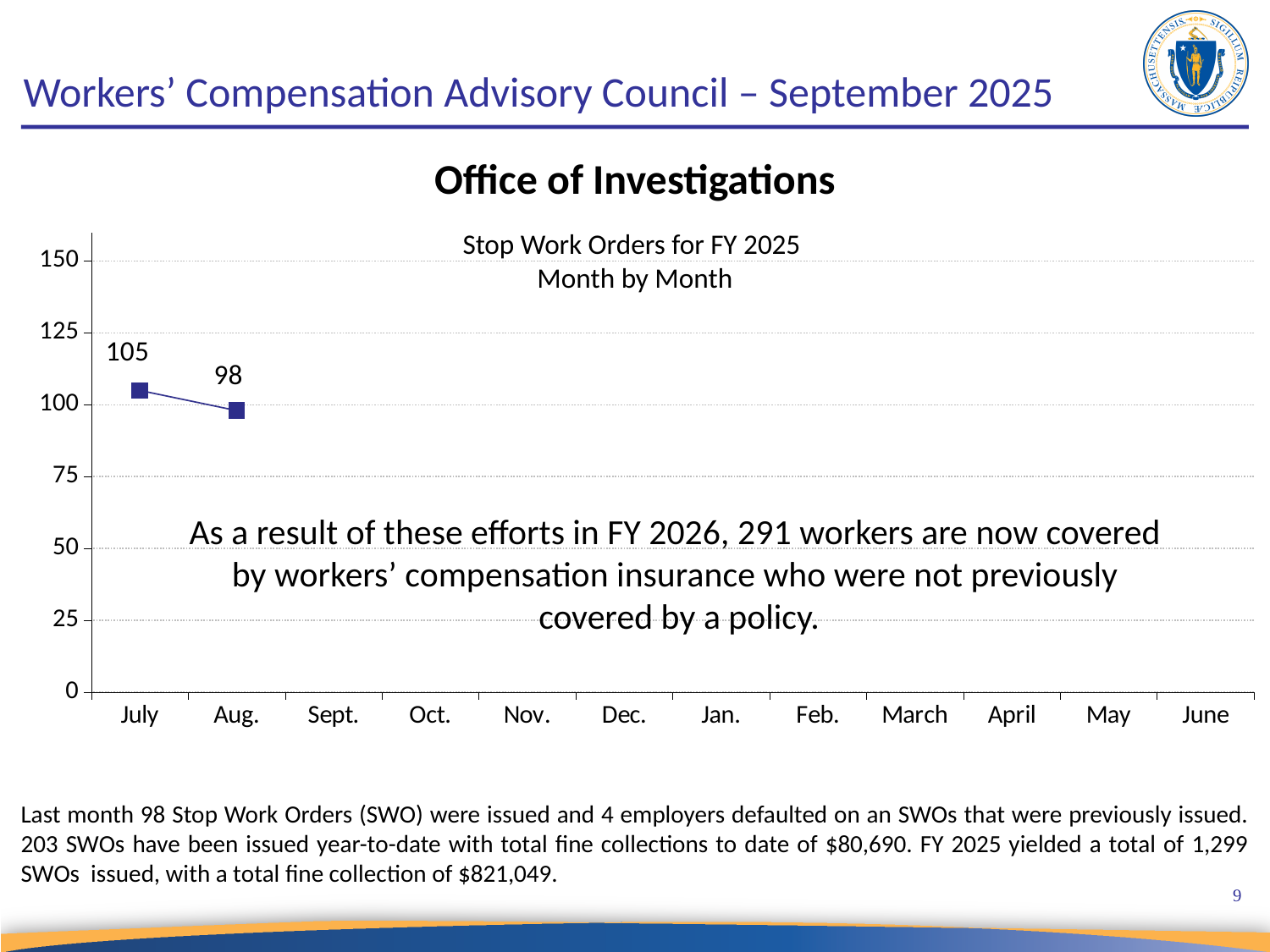
Is the value for Aug. in the Stop Work Orders chart greater or less than 100? less Do the plotted values rise or fall from July to Aug. in the Stop Work Orders chart? fall What kind of chart is the Stop Work Orders chart? line chart How many data points are plotted in the Stop Work Orders chart? 2 What is the value for Aug. in the Stop Work Orders chart? 98 Is the value for July in the Stop Work Orders chart greater or less than 100? greater Which is larger in the Stop Work Orders chart, the value for July or the value for Aug.? July Which month has the highest plotted value in the Stop Work Orders chart? July What is the difference between the July and Aug. values in the Stop Work Orders chart? 7 What is the value for July in the Stop Work Orders chart? 105 Which month has the lowest plotted value in the Stop Work Orders chart? Aug. How many months are labelled on the x axis of the Stop Work Orders chart? 12